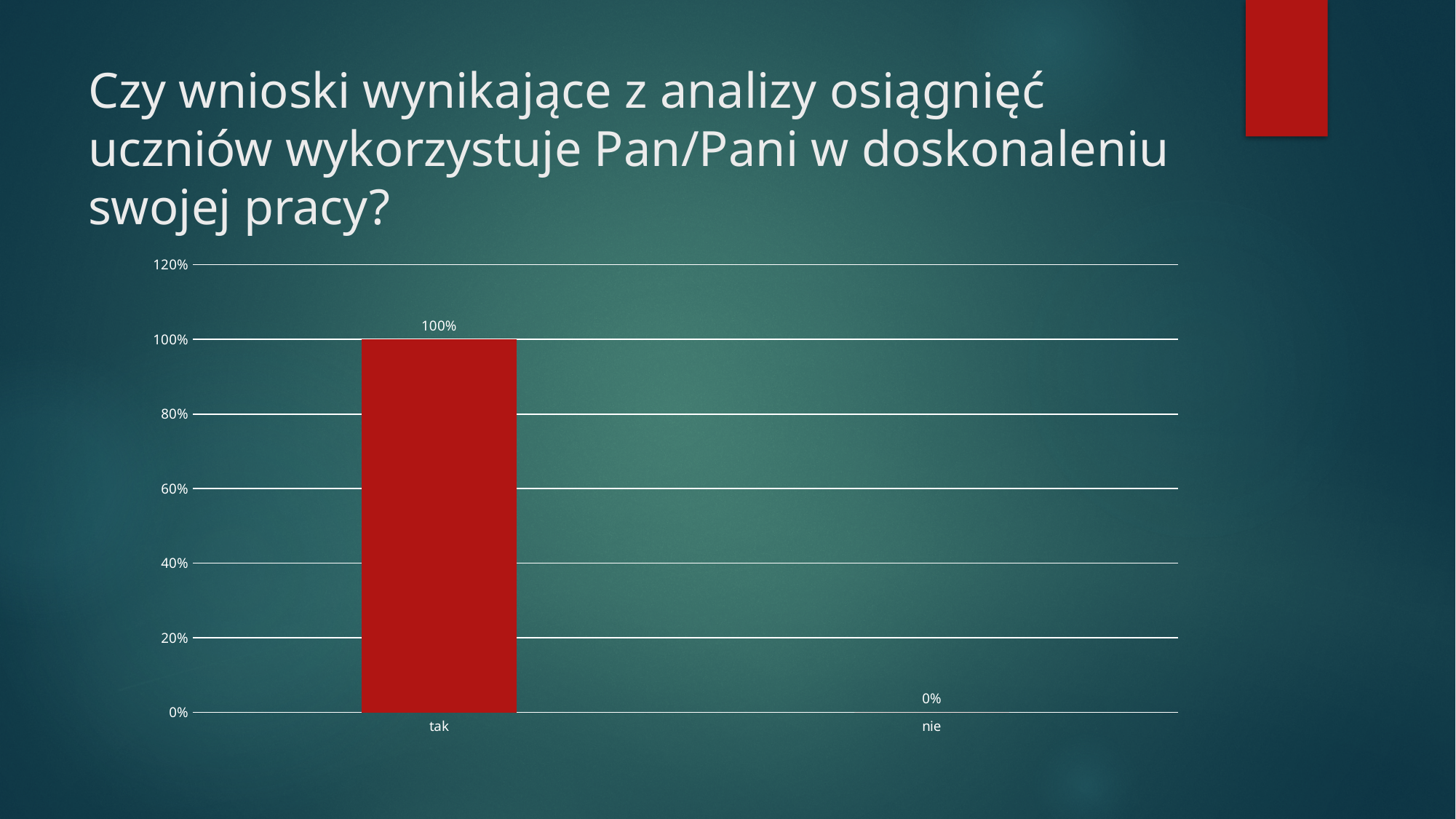
What colour is the bar for "tak"? red Which is larger, the value for "tak" or the value for "nie"? tak What is the highest value labelled on the vertical axis? 120% How many categories are shown on the x axis? 2 What is the difference between the values for "tak" and "nie"? 100% What kind of chart is shown on the slide? bar chart Do the values rise or fall from "tak" to "nie"? fall Which category has the lowest value? nie What is the value for "tak"? 100% Is the value for "tak" greater or less than 80%? greater Which category has the highest value? tak What is the value for "nie"? 0%